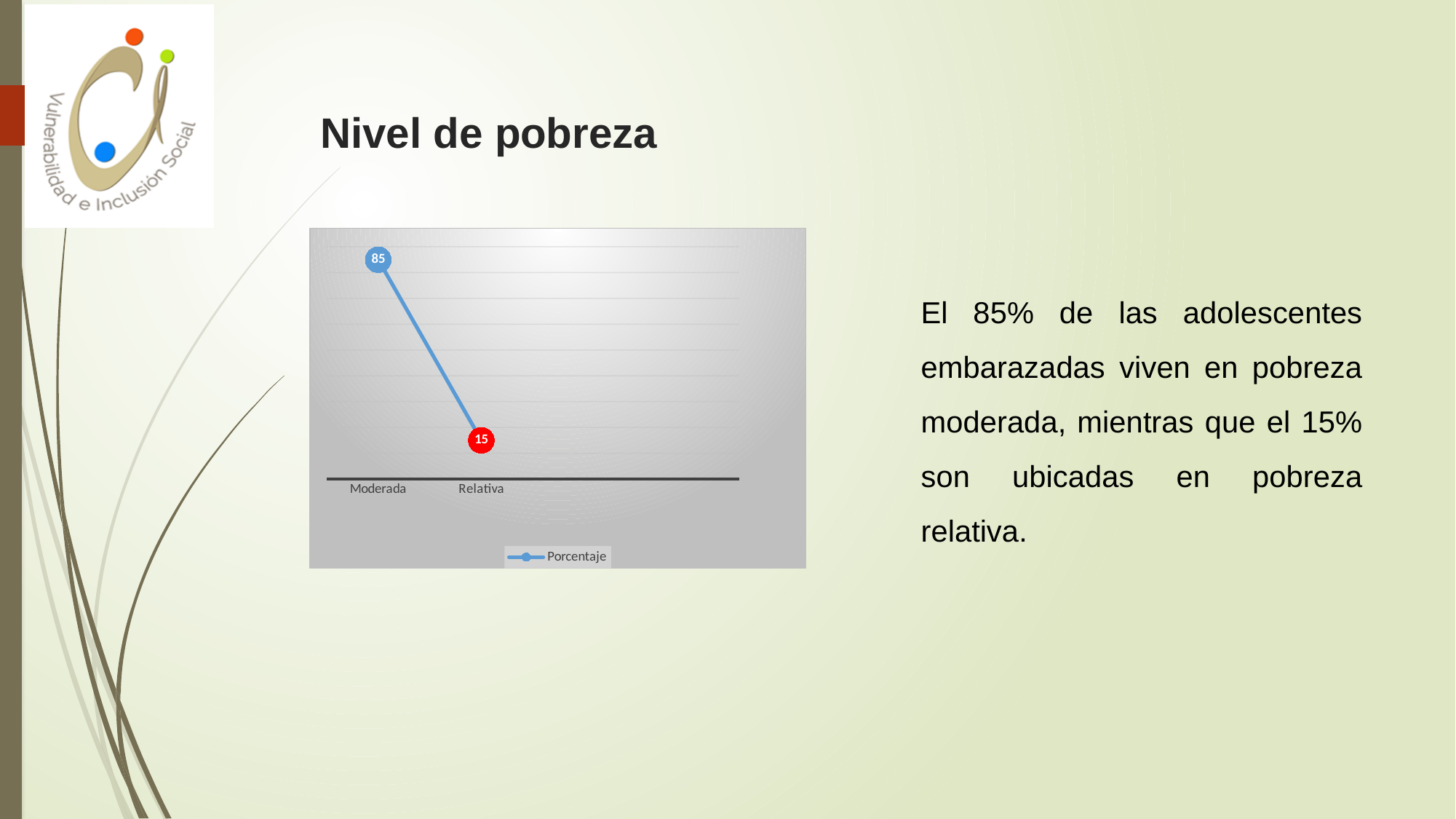
What is the value for Relativa? 15 What is the title of the slide containing the chart? Nivel de pobreza Which category has the highest value? Moderada Do the values rise or fall from Moderada to Relativa? fall Which is larger, the value for Moderada or the value for Relativa? Moderada Which category has the lowest value? Relativa How many series does the legend list? 1 How many categories are plotted on the chart? 2 What is the value for Moderada? 85 What is the difference between the values for Moderada and Relativa? 70 What kind of chart is shown on the slide? line chart What is the name of the series shown in the legend? Porcentaje